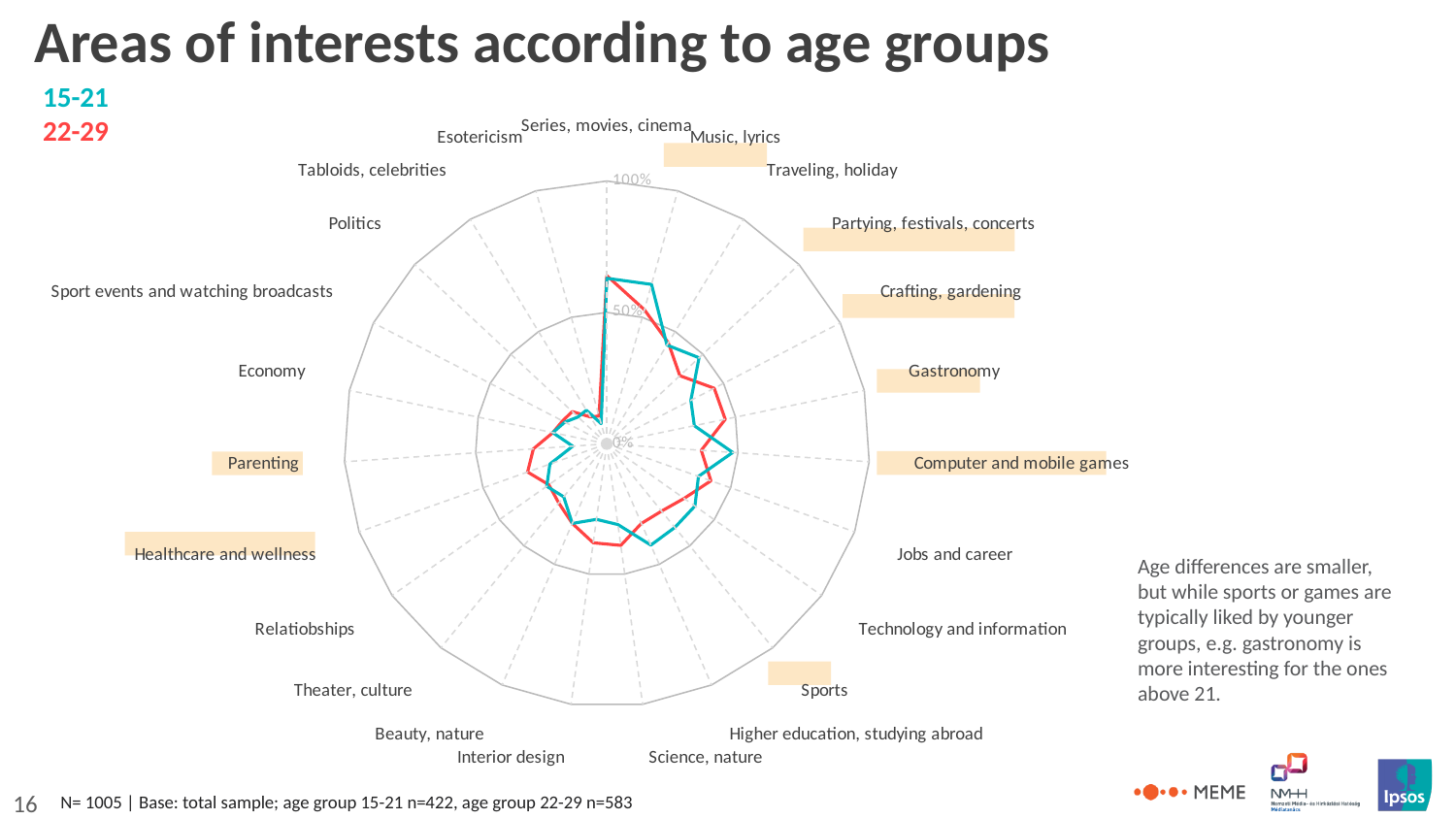
For Computer and mobile games, which age group has the higher value, 15-21 or 22-29? 15-21 Is the value for Esotericism in the 22-29 age group greater or less than 50%? less Is the value for Politics in the 15-21 age group greater or less than 50%? less Is the value for Series, movies, cinema in the 22-29 age group greater or less than 50%? greater How many age-group series does the chart plot? 2 What kind of chart is shown on the slide? Radar chart For Gastronomy, which age group has the higher value, 15-21 or 22-29? 22-29 How many areas of interest (categories) are plotted around the radar chart? 23 Which two age groups are compared in the chart? 15-21 and 22-29 What is the title of the chart? Areas of interests according to age groups